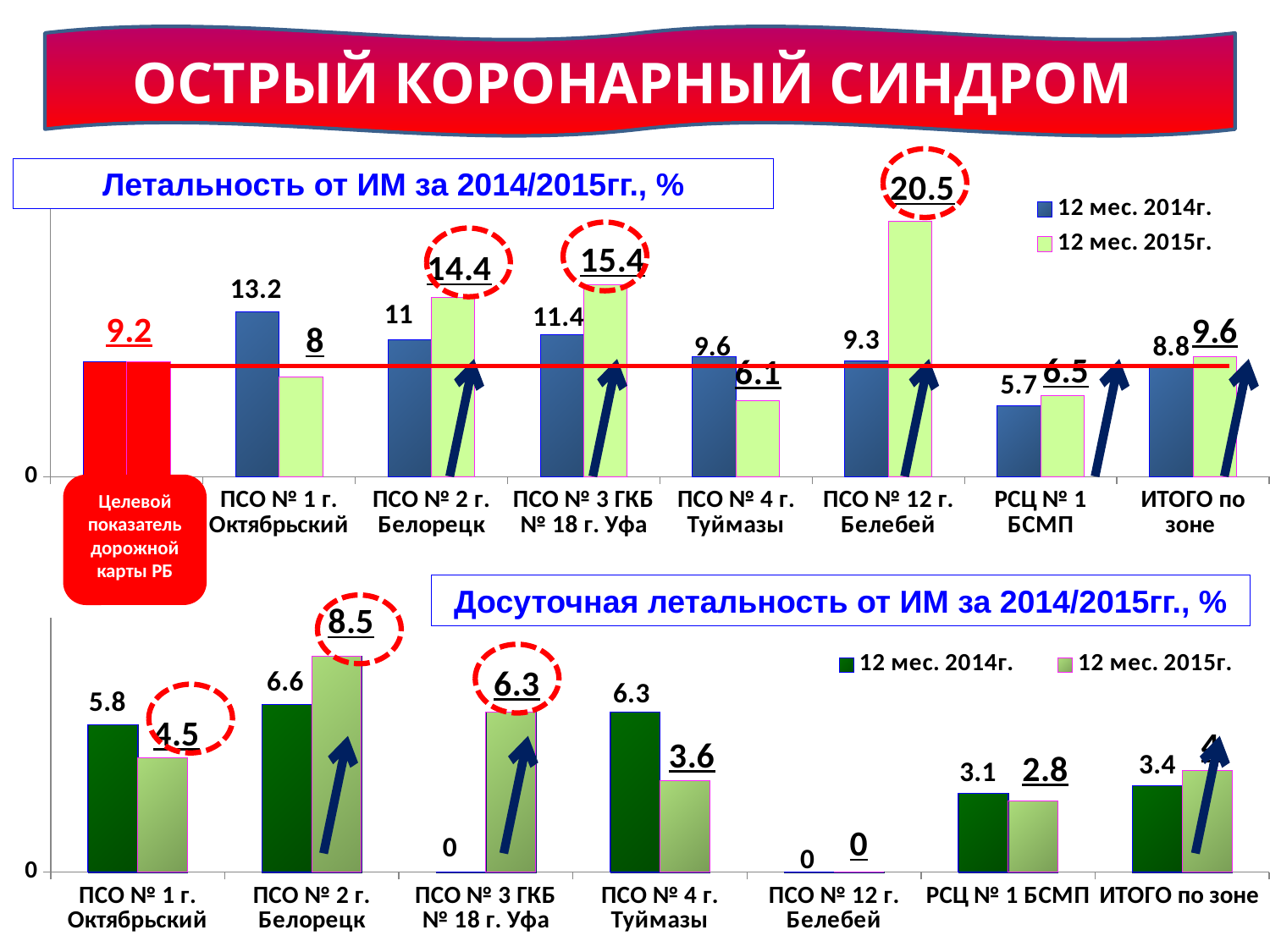
In the top chart 'Летальность от ИМ за 2014/2015гг., %', what is the value for ПСО № 1 г. Октябрьский for 12 мес. 2014г.? 13.2 In the top chart 'Летальность от ИМ за 2014/2015гг., %', what is the difference between the 2015 and 2014 values for ПСО № 3 ГКБ № 18 г. Уфа? 4 In the bottom chart 'Досуточная летальность от ИМ за 2014/2015гг., %', how many categories are shown on the x axis? 7 What type of chart is the bottom chart 'Досуточная летальность от ИМ за 2014/2015гг., %'? Bar chart In the bottom chart 'Досуточная летальность от ИМ за 2014/2015гг., %', what is the value for ИТОГО по зоне for 12 мес. 2014г.? 3.4 In the top chart 'Летальность от ИМ за 2014/2015гг., %', which category has the highest value for 12 мес. 2015г.? ПСО № 12 г. Белебей In the bottom chart 'Досуточная летальность от ИМ за 2014/2015гг., %', which is larger for ПСО № 4 г. Туймазы: the 12 мес. 2014г. value or the 12 мес. 2015г. value? 12 мес. 2014г. In the top chart 'Летальность от ИМ за 2014/2015гг., %', how many series does the legend list? 2 In the bottom chart 'Досуточная летальность от ИМ за 2014/2015гг., %', what is the value for ПСО № 2 г. Белорецк for 12 мес. 2015г.? 8.5 In the top chart 'Летальность от ИМ за 2014/2015гг., %', what is the value for ПСО № 12 г. Белебей for 12 мес. 2015г.? 20.5 In the top chart 'Летальность от ИМ за 2014/2015гг., %', which category has the lowest value for 12 мес. 2014г.? РСЦ № 1 БСМП In the top chart 'Летальность от ИМ за 2014/2015гг., %', what is the target value (Целевой показатель) shown by the red line? 9.2